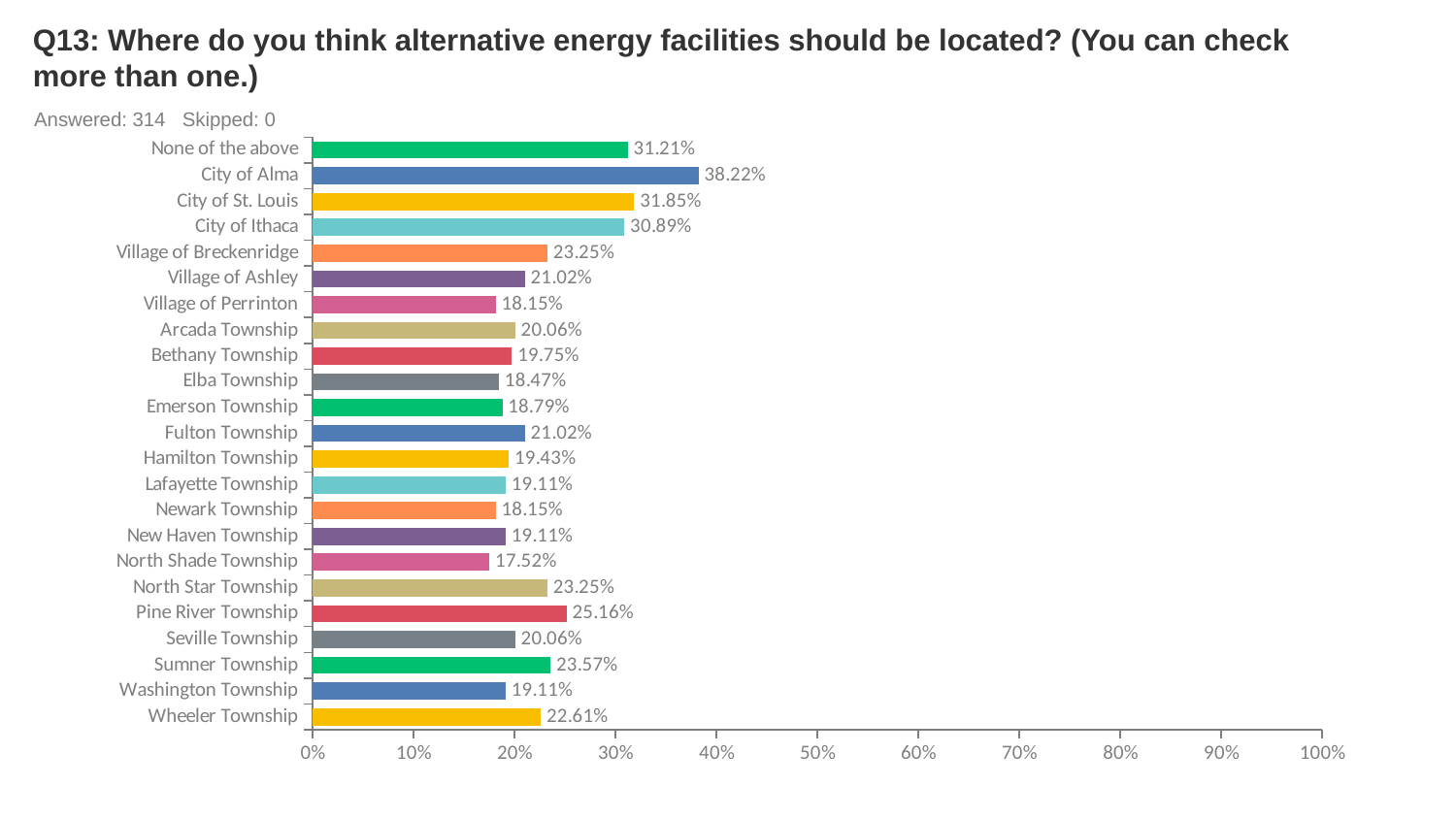
How many categories are shown in the chart? 23 What is the value shown for Pine River Township? 25.16% What percentage of respondents chose City of Alma? 38.22% What is the difference between the values for City of Alma and City of St. Louis? 6.37% What is the difference between the values for Pine River Township and Wheeler Township? 2.55% What is the value for Village of Breckenridge? 23.25% Which is larger, the value for Sumner Township or the value for Seville Township? Sumner Township Which category has the highest percentage? City of Alma What kind of chart is shown on the slide? Bar chart Which category has the lowest percentage? North Shade Township What percentage is shown for North Shade Township? 17.52% Is the value for City of Ithaca greater or less than 20%? greater